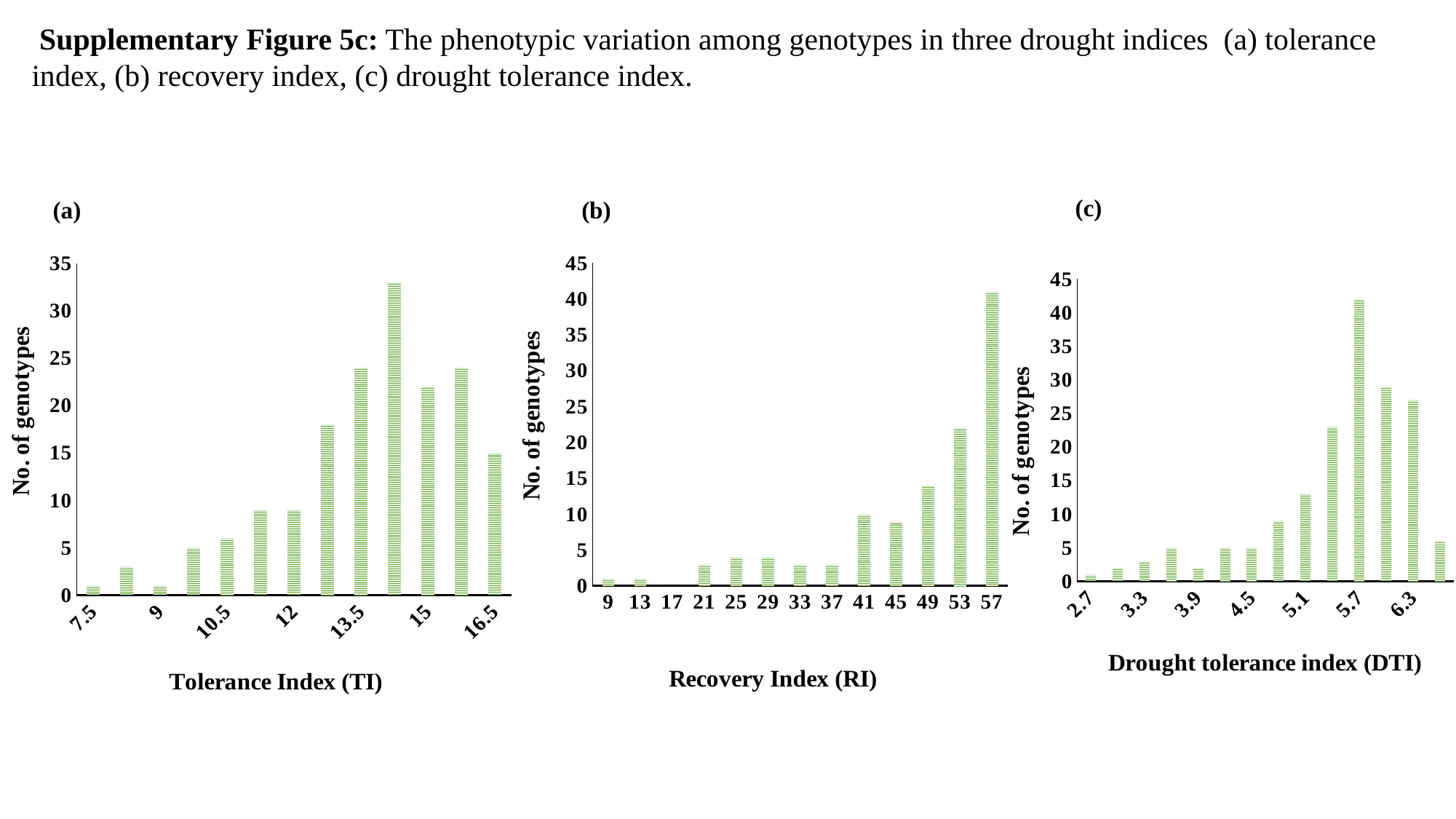
In chart (a), Tolerance Index (TI), is the value for 13.5 greater or less than 20? greater In chart (c), Drought tolerance index (DTI), is the value for 6.3 greater or less than 20? greater In chart (b), Recovery Index (RI), how many categories are labelled on the x axis? 13 In chart (a), Tolerance Index (TI), which is larger, the value for 13.5 or the value for 16.5? 13.5 In chart (b), Recovery Index (RI), is the value for 57 greater or less than 35? greater In chart (b), Recovery Index (RI), which category has the highest value? 57 What kind of chart is chart (a), Tolerance Index (TI)? bar chart In chart (b), Recovery Index (RI), do the values generally rise or fall from left to right along the x axis? rise In chart (c), Drought tolerance index (DTI), which category has the highest value? 5.7 What is the y-axis label of chart (c), Drought tolerance index (DTI)? No. of genotypes